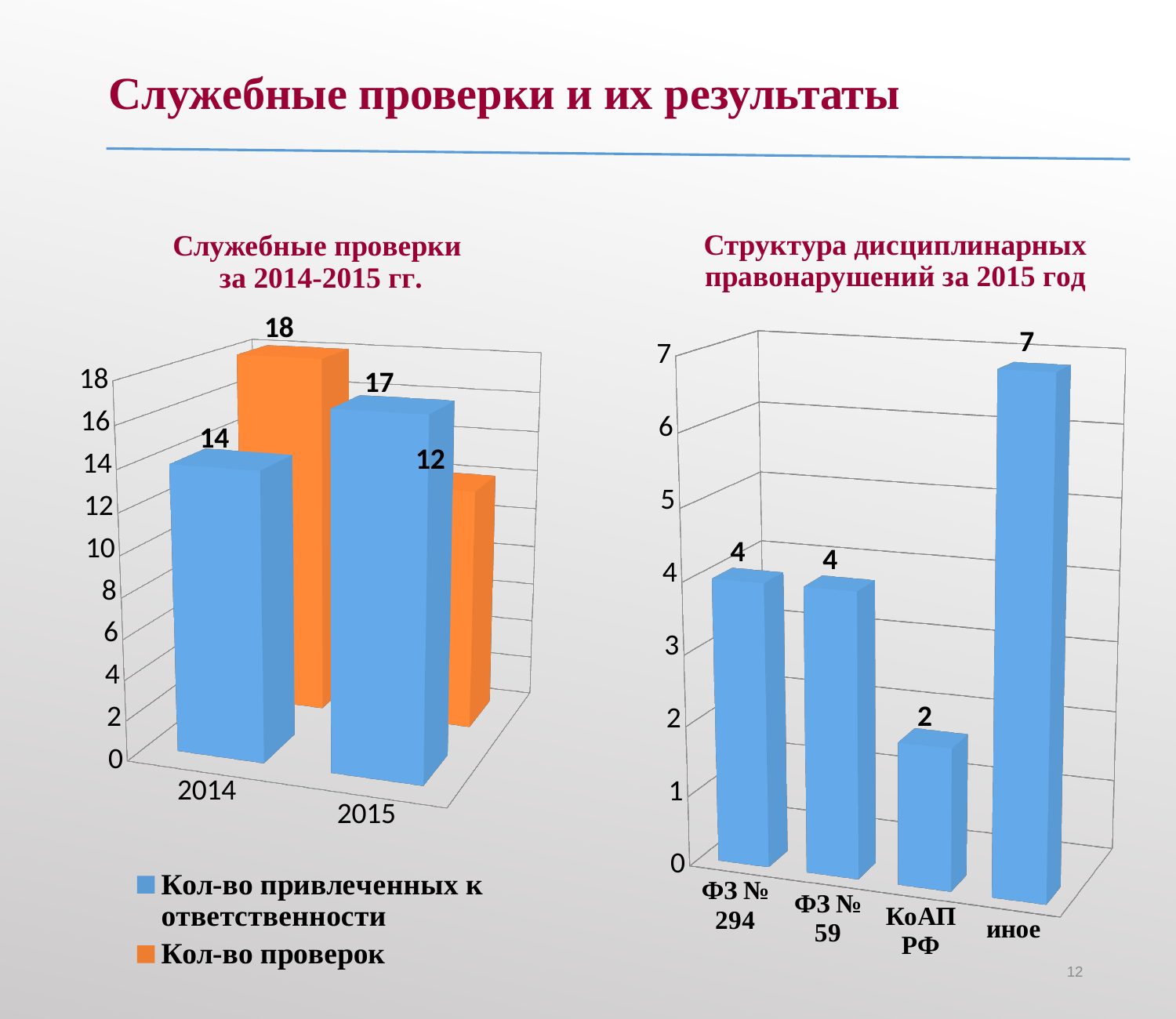
In the chart 'Служебные проверки за 2014-2015 гг.', does 'Кол-во привлеченных к ответственности' rise or fall from 2014 to 2015? rise In the chart 'Служебные проверки за 2014-2015 гг.', what is the value of 'Кол-во проверок' for 2014? 18 In the chart 'Служебные проверки за 2014-2015 гг.', which is larger for 2014: 'Кол-во привлеченных к ответственности' or 'Кол-во проверок'? Кол-во проверок In the chart 'Служебные проверки за 2014-2015 гг.', what is the value of 'Кол-во проверок' for 2015? 12 How many categories are shown in the chart 'Структура дисциплинарных правонарушений за 2015 год'? 4 In the chart 'Структура дисциплинарных правонарушений за 2015 год', which category has the lowest value? КоАП РФ In the chart 'Структура дисциплинарных правонарушений за 2015 год', which category has the highest value? иное In the chart 'Структура дисциплинарных правонарушений за 2015 год', what is the value for 'ФЗ № 59'? 4 In the chart 'Структура дисциплинарных правонарушений за 2015 год', what is the difference between 'иное' and 'КоАП РФ'? 5 How many series does the legend of the chart 'Служебные проверки за 2014-2015 гг.' list? 2 In the chart 'Служебные проверки за 2014-2015 гг.', by how much did 'Кол-во проверок' change from 2014 to 2015? 6 In the chart 'Служебные проверки за 2014-2015 гг.', what is the value of 'Кол-во привлеченных к ответственности' for 2015? 17